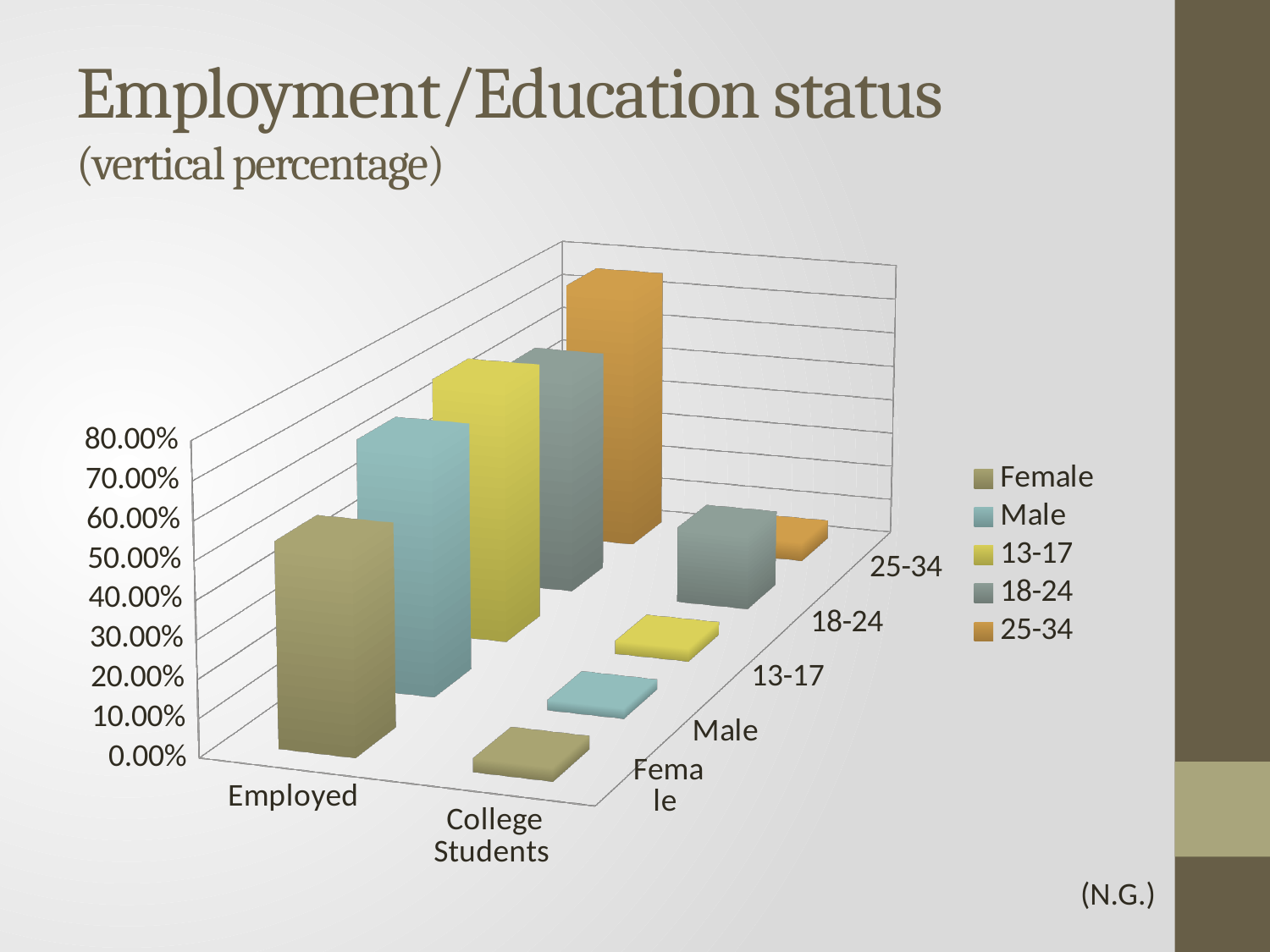
Is the value for Female in the College Students category greater or less than 20.00%? less Is the value for Male in the College Students category greater or less than 20.00%? less Which series has the highest value in the Employed category? 25-34 Which series are listed in the legend? Female, Male, 13-17, 18-24, 25-34 How many series does the legend list? 5 Is the value for Female in the Employed category greater or less than 30.00%? greater What is the title of the chart? Employment/Education status (vertical percentage) How many categories are shown along the x axis? 2 What kind of chart is shown on the slide? bar chart For the Female series, which category has the larger value: Employed or College Students? Employed For the 25-34 series, which category has the larger value: Employed or College Students? Employed